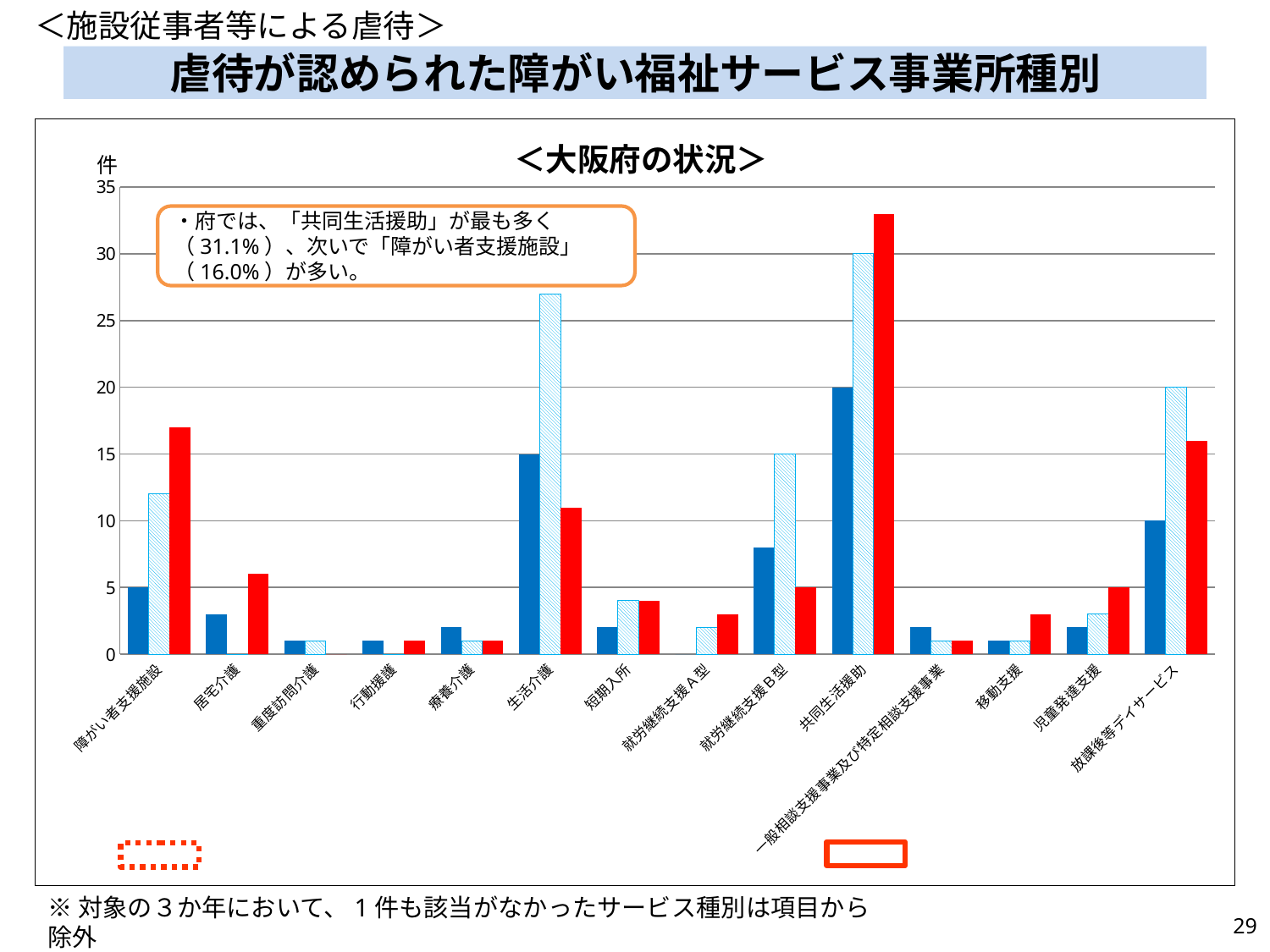
For 障がい者支援施設, which is larger: the red bar or the blue bar? the red bar Which category has the tallest red bar in the chart? 共同生活援助 Is the red bar for 共同生活援助 greater or less than 30? greater What is the value of the hatched light-blue bar for 共同生活援助? 30 What is the value of the hatched light-blue bar for 放課後等デイサービス? 20 Is the red bar for 障がい者支援施設 greater or less than 15? greater What kind of chart is shown on the slide? bar chart What is the value of the blue bar for 生活介護? 15 What is the value of the blue bar for 共同生活援助? 20 What is the subtitle shown above the chart's plot area? ＜大阪府の状況＞ How many service categories are shown along the x axis of the chart? 14 Is the hatched light-blue bar for 生活介護 greater or less than 25? greater